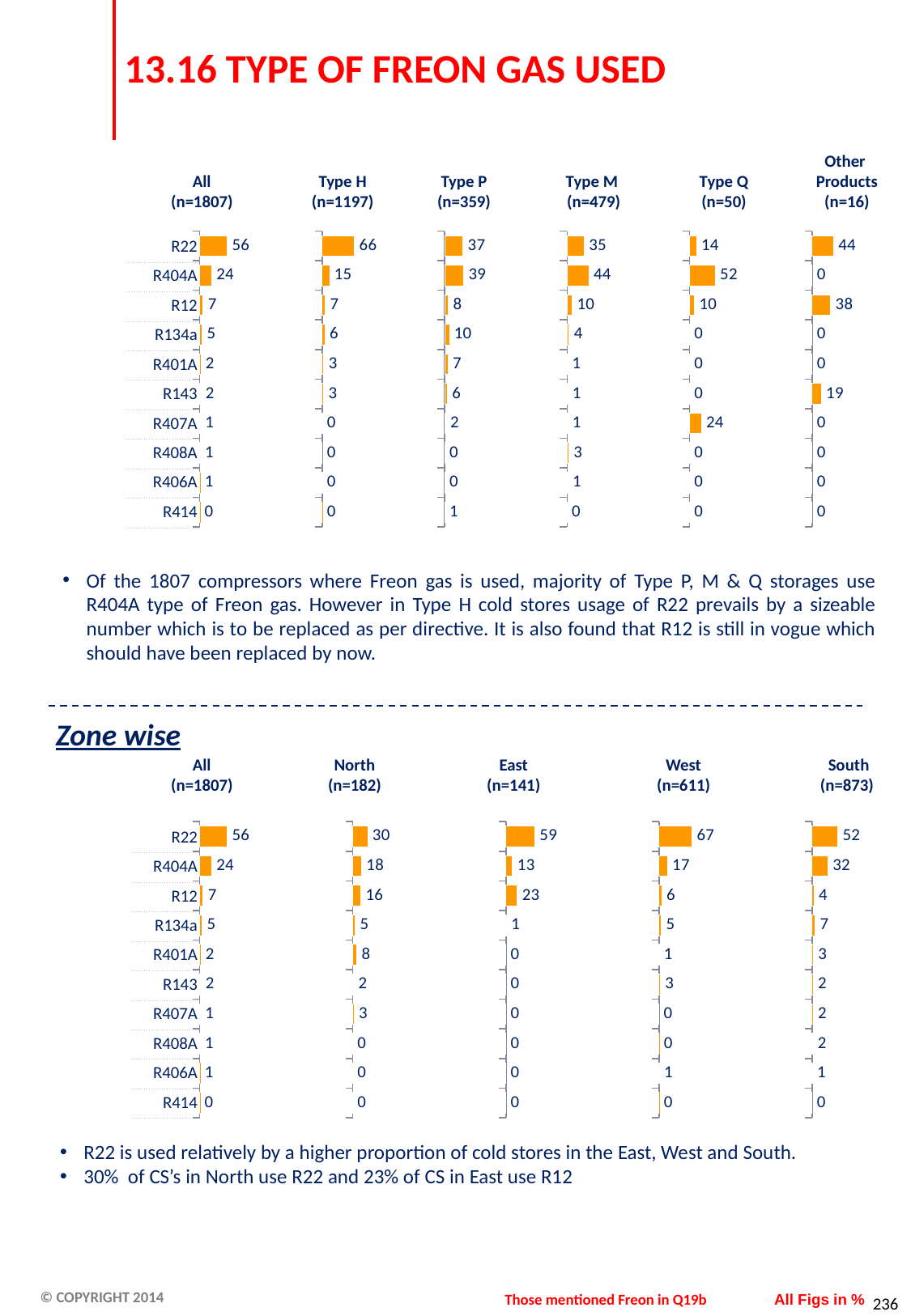
How many Freon gas categories are listed in each chart of the top set? 10 In the top set of charts, what is the difference between R22 and R404A in the All (n=1807) chart? 32 In the Zone wise charts, which zone has the highest value for R22? West In the top set of charts, what is the value for R22 in the Type H (n=1197) chart? 66 What type of chart is used to show the Freon gas data on this slide? Bar chart In the Zone wise charts, what is the value for R12 in the East (n=141) chart? 23 In the top set of charts, what is the value for R143 in the Other Products (n=16) chart? 19 In the top set of charts, what is the value for R404A in the Type Q (n=50) chart? 52 In the top set of charts, which is larger in the Type P (n=359) chart: R22 or R404A? R404A In the Zone wise charts, what is the value for R401A in the North (n=182) chart? 8 In the Zone wise charts, what is the difference between R22 and R404A in the South (n=873) chart? 20 In the top set of charts, which Freon gas has the highest value in the Type M (n=479) chart? R404A